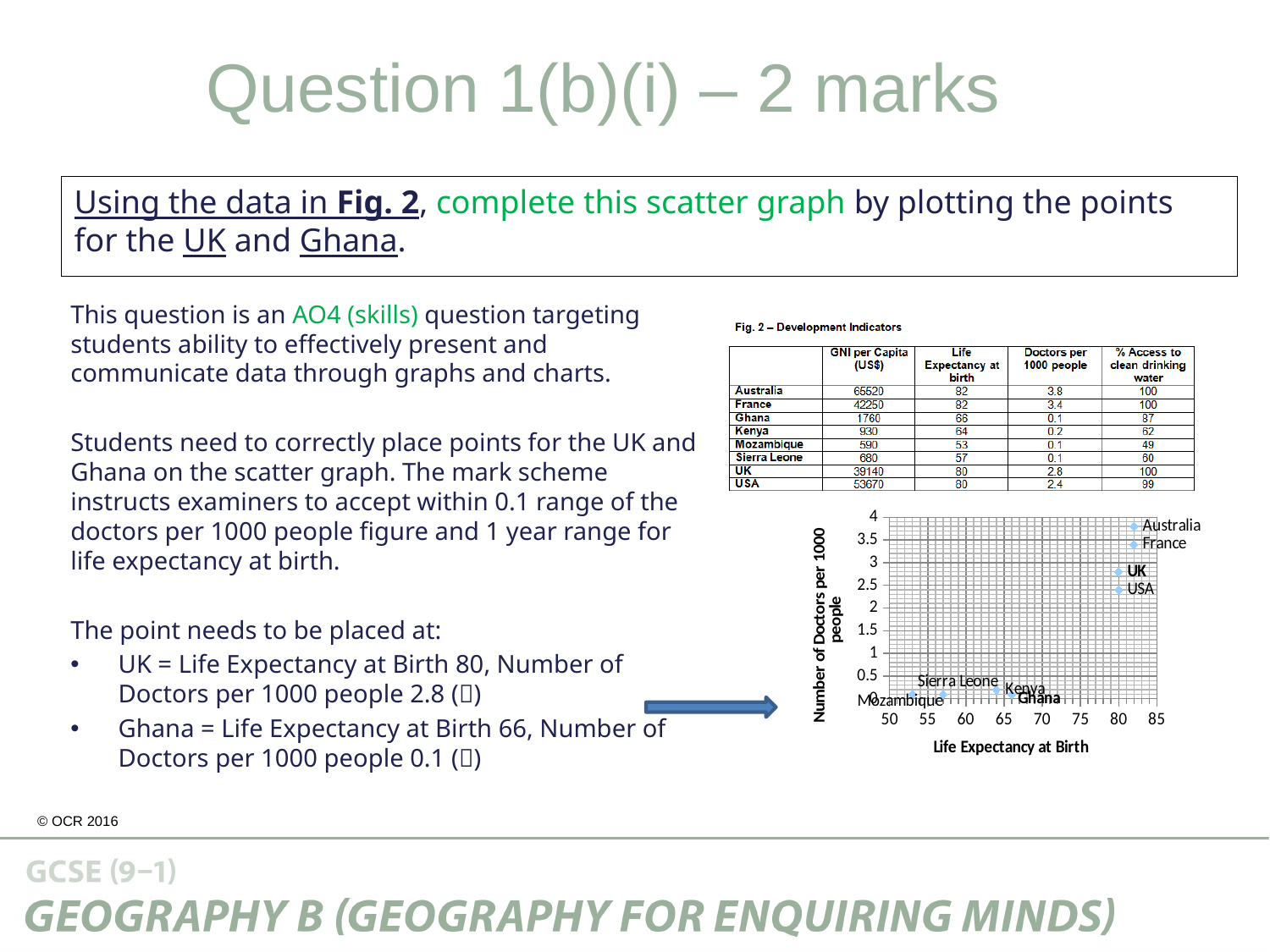
What is the title of the y axis on the scatter graph? Number of Doctors per 1000 people Is the number of doctors per 1000 people for Australia greater or less than 3.5? greater Is the number of doctors per 1000 people for Mozambique greater or less than 0.5? less On the scatter graph, what is the life expectancy at birth plotted for the UK? 80 Which has more doctors per 1000 people on the scatter graph, the UK or the USA? UK Is the number of doctors per 1000 people for France greater or less than 3? greater Which country has the lowest life expectancy at birth on the scatter graph? Mozambique Which country has the highest number of doctors per 1000 people on the scatter graph? Australia As life expectancy at birth increases along the x axis, does the number of doctors per 1000 people generally rise or fall? rise What kind of chart is shown on the slide? Scatter graph How many countries are plotted on the scatter graph? 8